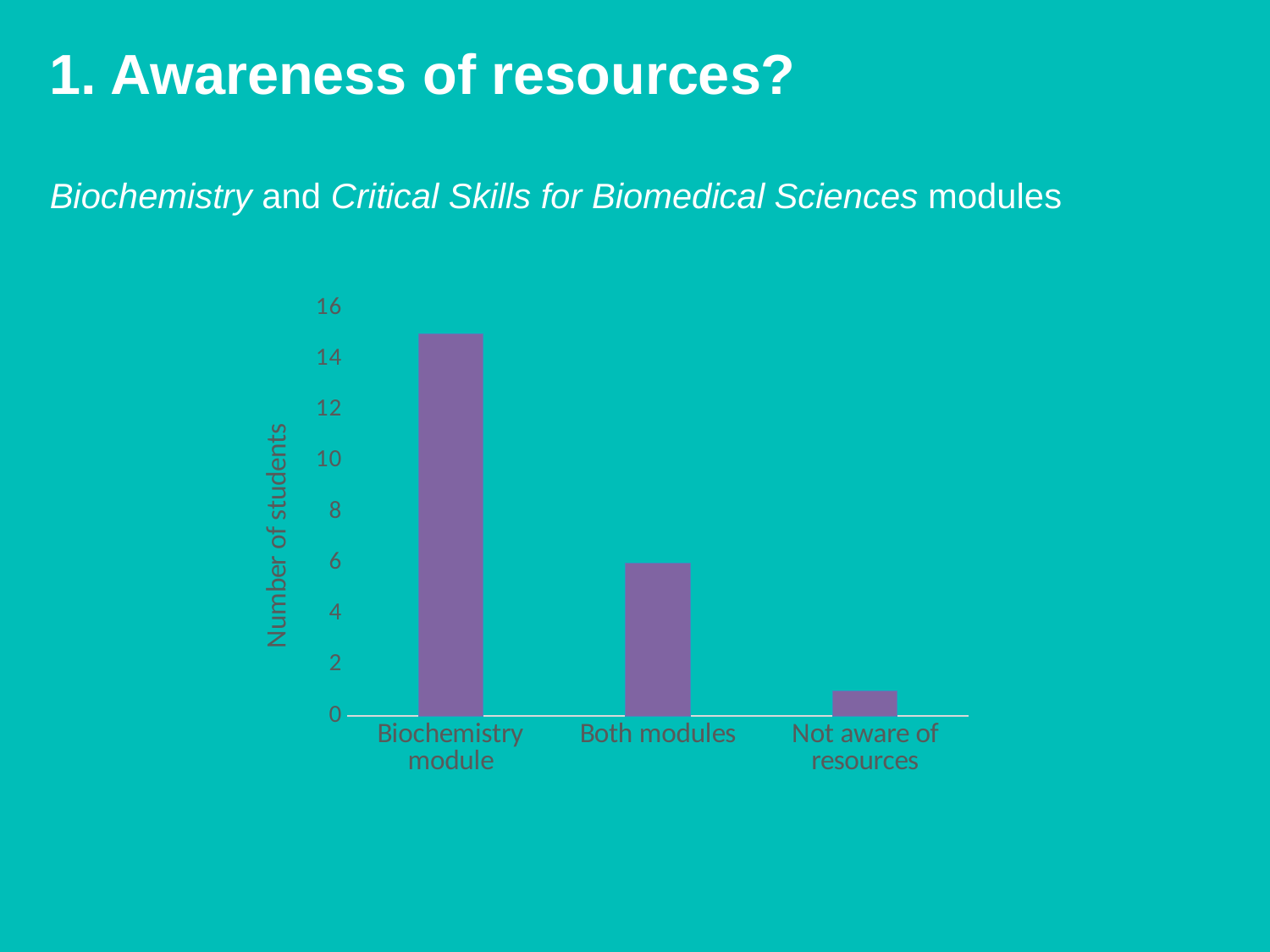
What colour are the bars in the chart? purple Do the values rise or fall moving from left to right along the x axis? fall Is the value for Both modules greater or less than 10? less Which category has the highest number of students? Biochemistry module Which is larger, the value for Biochemistry module or the value for Both modules? Biochemistry module What kind of chart is shown on the slide? bar chart What is the label on the vertical axis of the chart? Number of students Is the value for Not aware of resources greater or less than 2? less Which category has the lowest number of students? Not aware of resources Is the value for Biochemistry module greater or less than 14? greater How many categories are shown on the x axis of the chart? 3 What is the number of students for Both modules? 6